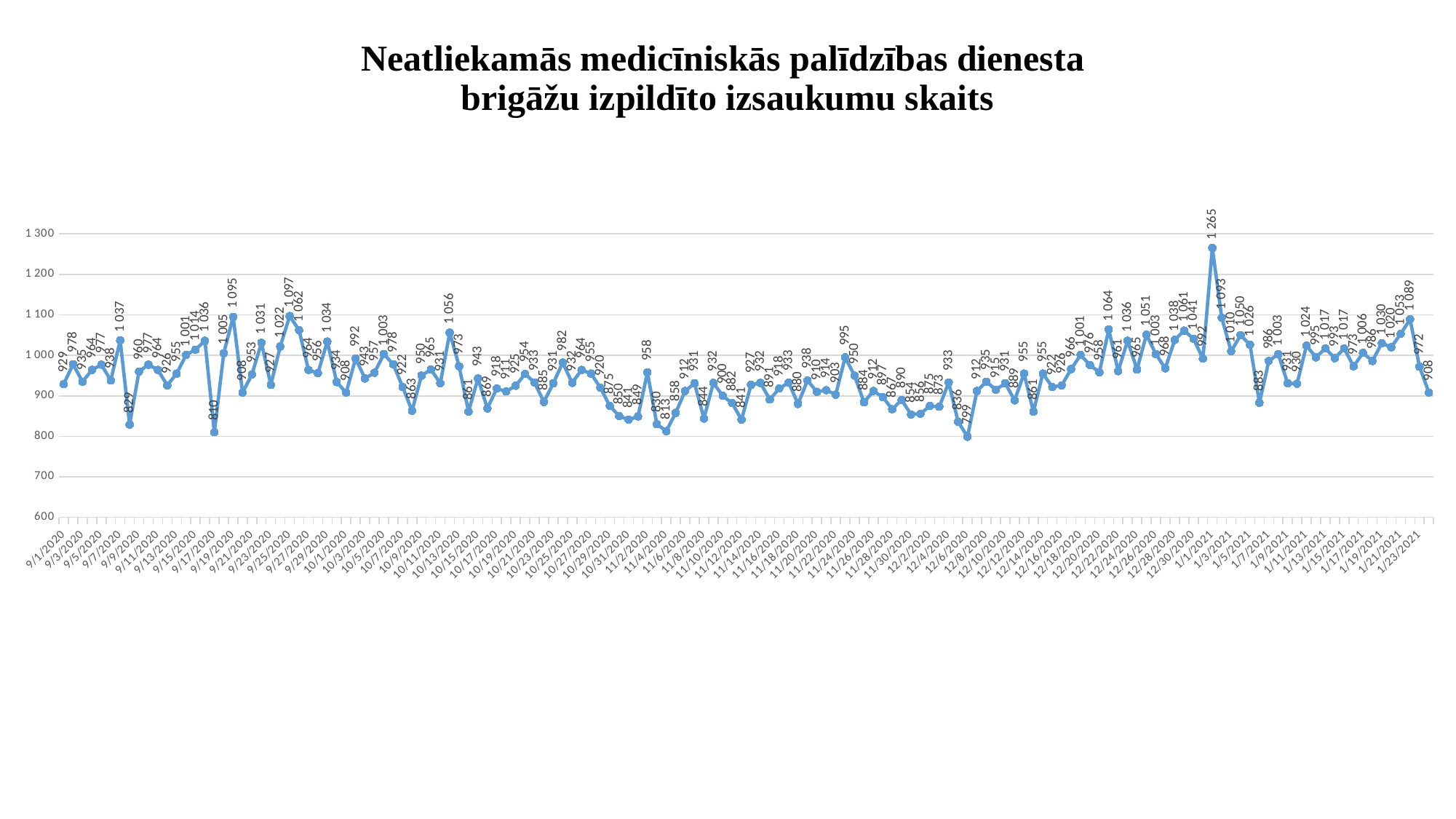
What is the value for 9/1/2020? 929 What is the value for 9/19/2020? 1 095 What is the difference between the highest value (1 265) and the lowest value (799) on the chart? 466 What is the value for 1/23/2021? 972 What is the lowest value plotted on the chart? 799 What is the highest value shown on the vertical axis? 1 300 What type of chart is shown on the slide? line chart What is the value for 9/17/2020? 810 Is the value for 9/17/2020 greater or less than 900? less What is the title of the chart? Neatliekamās medicīniskās palīdzības dienesta brigāžu izpildīto izsaukumu skaits What is the highest value plotted on the chart? 1 265 Which date has the larger value, 9/17/2020 or 9/19/2020? 9/19/2020